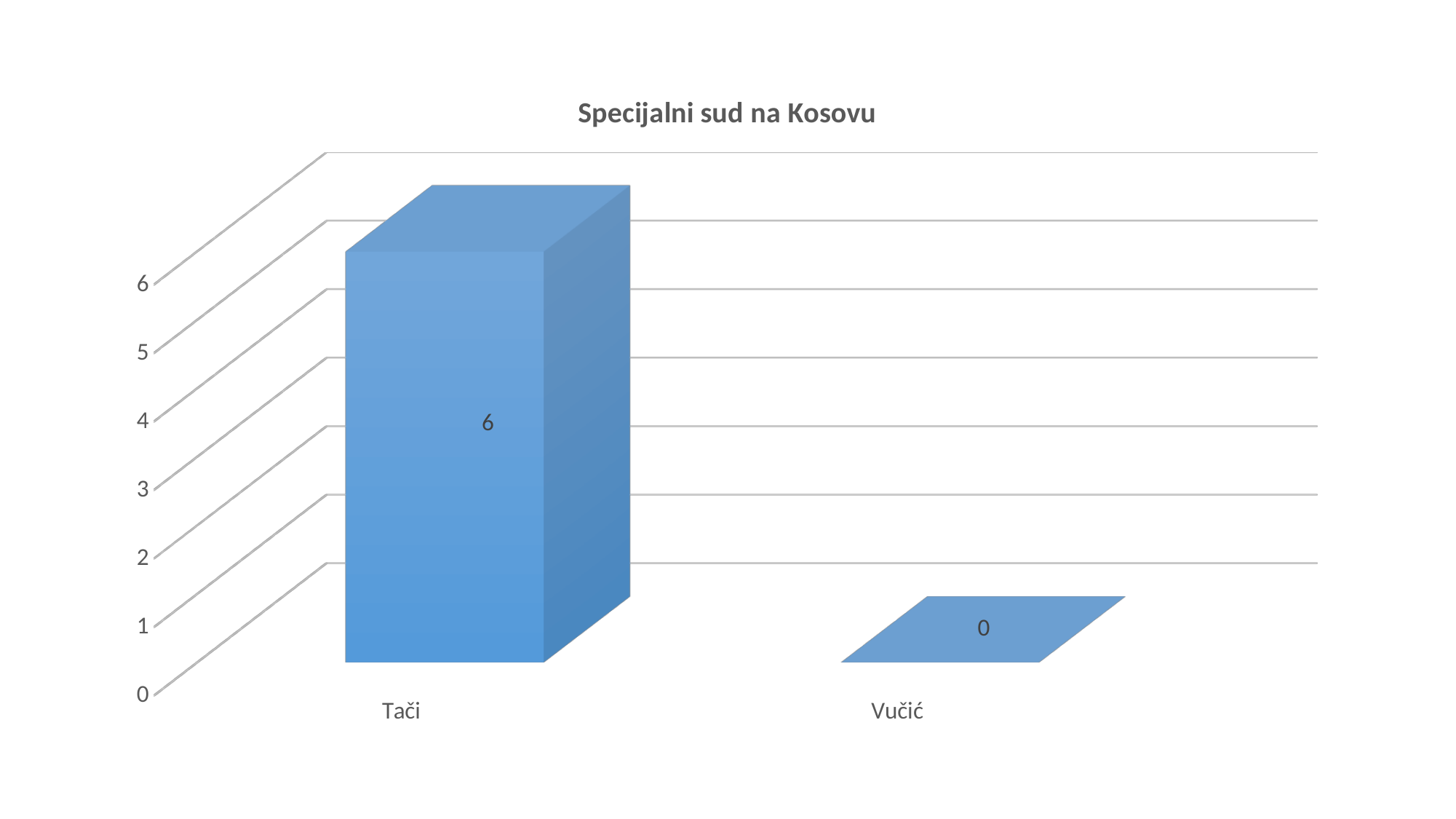
What is the highest value shown on the vertical axis? 6 What is the value for Vučić? 0 What kind of chart is shown on the slide? bar chart What is the difference between the values for Tači and Vučić? 6 How many categories are shown on the x axis? 2 Which category has the lowest value? Vučić Is the value for Tači greater or less than 3? greater Do the values rise or fall from Tači to Vučić? fall Which category has the highest value? Tači Which is larger, the value for Tači or the value for Vučić? Tači What is the value for Tači? 6 What is the title of the chart? Specijalni sud na Kosovu